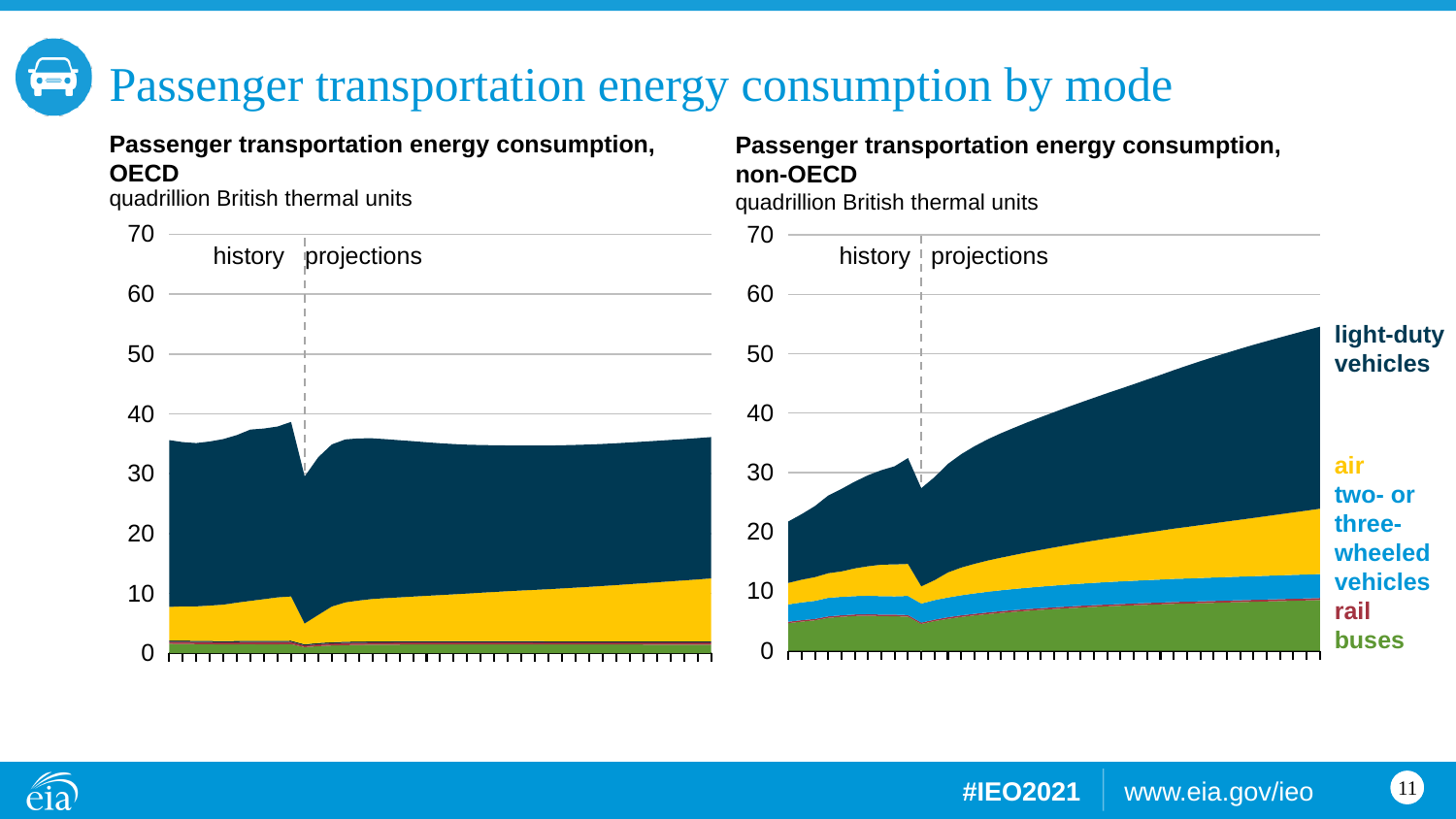
At the end of the projection period, which chart shows higher total passenger transportation energy consumption, OECD or non-OECD? non-OECD How many transportation modes (series) are listed in the legend on the right of the slide? 5 In the Passenger transportation energy consumption, non-OECD chart, is the total energy consumption at the start of the history period greater or less than 30? less What do the two labels on either side of the dashed vertical line in each chart say? history and projections What kind of chart is used for the Passenger transportation energy consumption, OECD chart? Stacked area chart What unit of measurement is used on both charts? quadrillion British thermal units In the Passenger transportation energy consumption, non-OECD chart, does total energy consumption rise or fall over the projection period? rise In the Passenger transportation energy consumption, OECD chart, is the total energy consumption at the start of the history period greater or less than 30? greater In the Passenger transportation energy consumption, non-OECD chart, which mode accounts for the largest share of energy consumption? light-duty vehicles In the Passenger transportation energy consumption, OECD chart, is the total energy consumption at the end of the projection period greater or less than 40? less In the Passenger transportation energy consumption, non-OECD chart, which mode accounts for the smallest share of energy consumption? rail